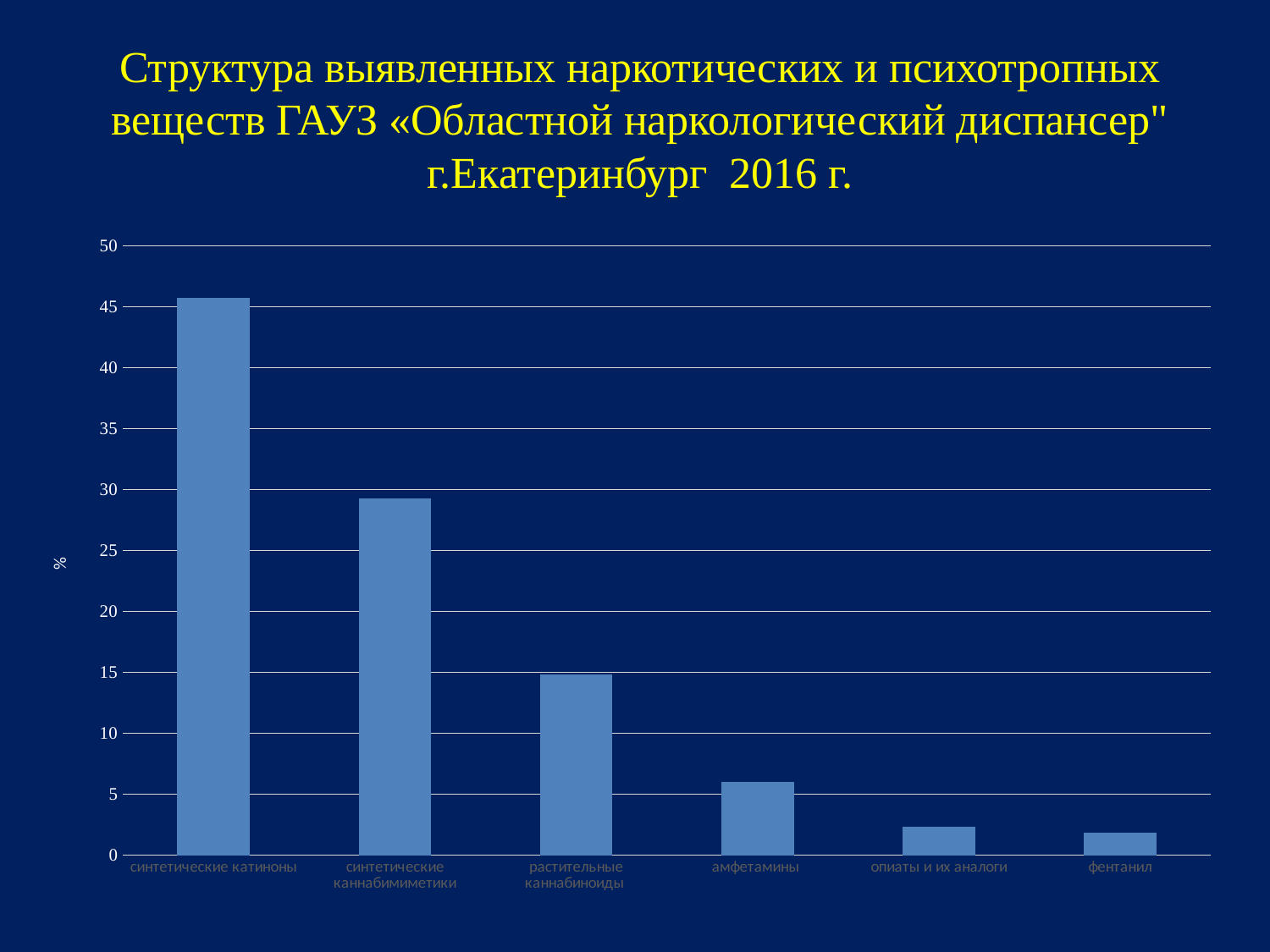
Is the value for растительные каннабиноиды greater or less than 20? less Is the value for синтетические каннабимиметики greater or less than 25? greater How many categories are shown on the x axis of the chart? 6 Which category has the highest value in the chart? синтетические катиноны What type of chart is shown on the slide? bar chart Is the value for амфетамины greater or less than 10? less Do the values rise or fall from left to right along the x axis? fall Which is larger: the value for амфетамины or the value for фентанил? амфетамины What unit is shown on the y axis label of the chart? % Which is larger: the value for синтетические каннабимиметики or the value for растительные каннабиноиды? синтетические каннабимиметики